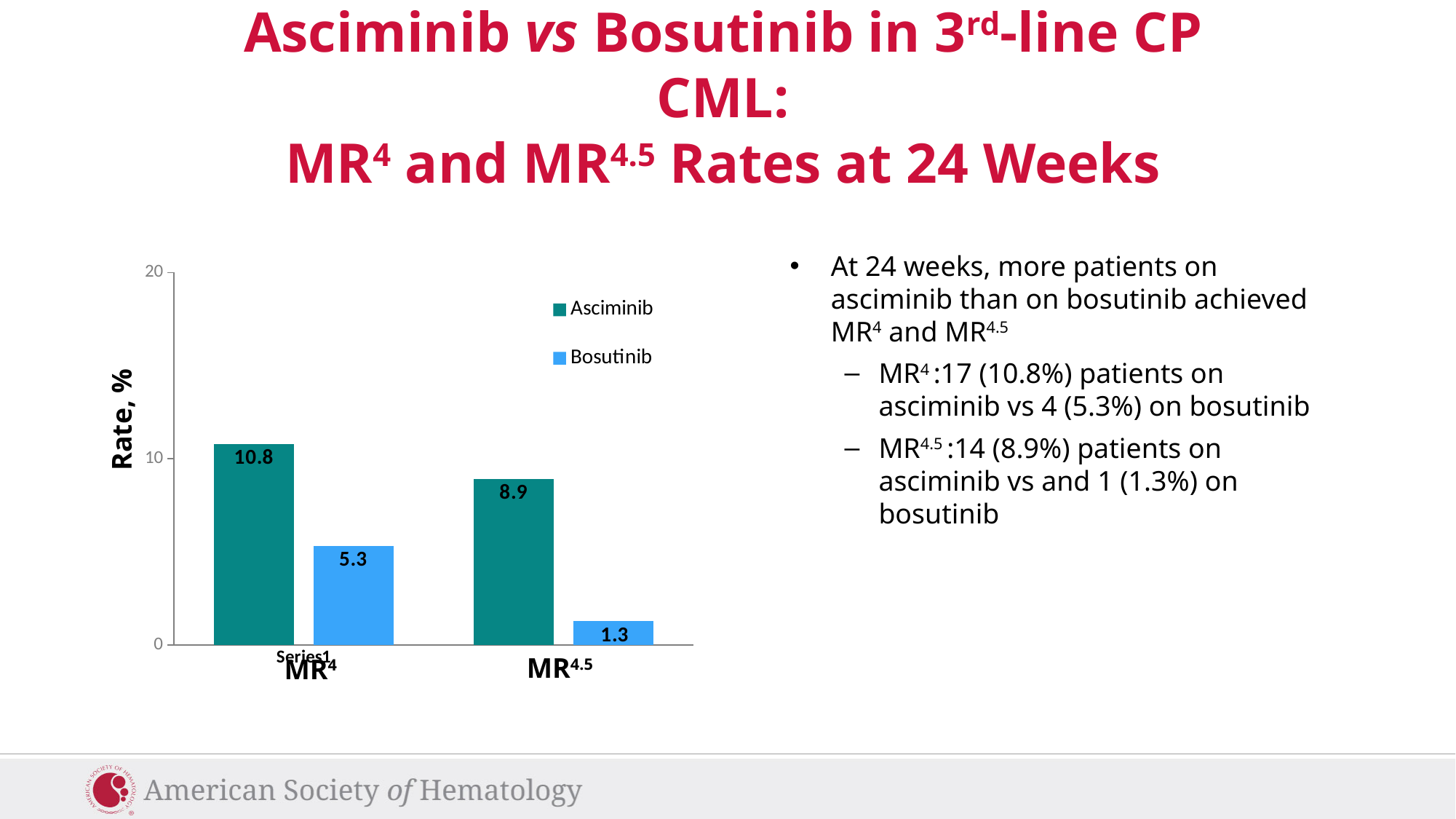
Which is larger for MR4.5: the asciminib rate or the bosutinib rate? Asciminib What is the bosutinib rate for MR4? 5.3 How many series does the legend list? 2 What is the bosutinib rate for MR4.5? 1.3 Which bar has the lowest value on the chart? Bosutinib, MR4.5 What kind of chart is shown on the slide? Bar chart Which bar has the highest value on the chart? Asciminib, MR4 What is the asciminib rate for MR4.5? 8.9 What is the asciminib rate for MR4? 10.8 What is the difference between the asciminib and bosutinib rates for MR4? 5.5 What is the label of the y axis? Rate, % What is the difference between the asciminib and bosutinib rates for MR4.5? 7.6